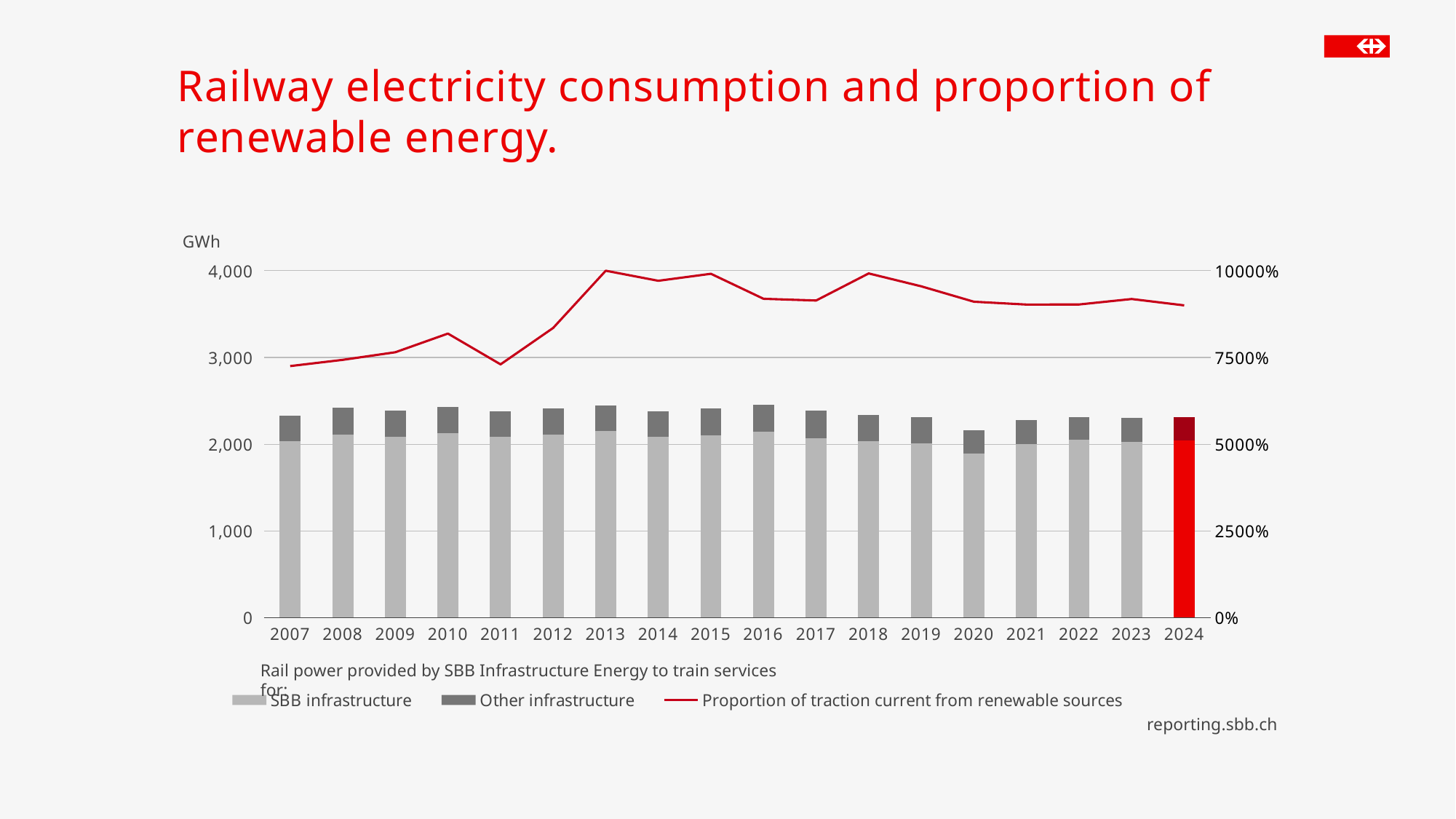
Which is larger, the total bar for 2007 or the total bar for 2020? 2007 How many years are shown on the x axis of the chart? 18 What unit is shown on the left axis of the chart? GWh Which year has the lowest total bar (total rail power)? 2020 Does the proportion of traction current from renewable sources line rise or fall overall from 2018 to 2024? fall What is the title of the slide? Railway electricity consumption and proportion of renewable energy. Is the proportion of traction current from renewable sources in 2024 greater or less than 7500%? greater Is the SBB infrastructure value for 2020 greater or less than 2,000 GWh? less What kind of chart is shown on the slide? A combination chart with stacked bars and a line How many series does the chart legend list? 3 Is the total bar for 2024 greater or less than 2,000 GWh? greater